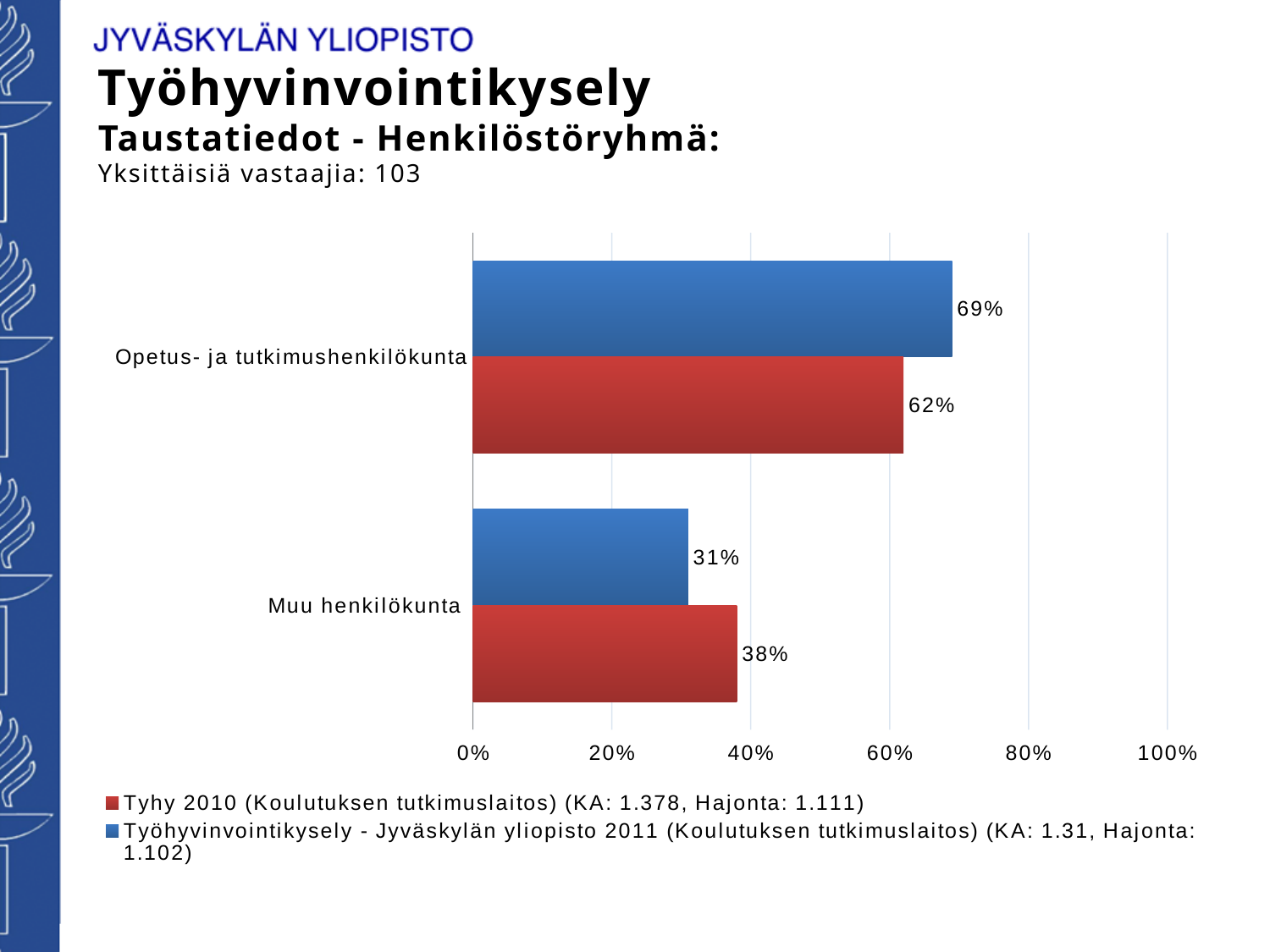
Which category has the highest value in the Työhyvinvointikysely - Jyväskylän yliopisto 2011 series? Opetus- ja tutkimushenkilökunta What kind of chart is shown on the slide? bar chart For Muu henkilökunta, which series has the larger value: Tyhy 2010 or Työhyvinvointikysely - Jyväskylän yliopisto 2011? Tyhy 2010 How many series does the legend list? 2 What is the value for Muu henkilökunta in the Tyhy 2010 series? 38% How many categories are shown on the chart? 2 What is the value for Muu henkilökunta in the Työhyvinvointikysely - Jyväskylän yliopisto 2011 series? 31% What is the difference between the 2011 and 2010 values for Opetus- ja tutkimushenkilökunta? 7% What is the difference between the 2010 and 2011 values for Muu henkilökunta? 7% Which category has the lowest value in the Tyhy 2010 series? Muu henkilökunta What is the value for Opetus- ja tutkimushenkilökunta in the Tyhy 2010 series? 62% What is the value for Opetus- ja tutkimushenkilökunta in the Työhyvinvointikysely - Jyväskylän yliopisto 2011 series? 69%